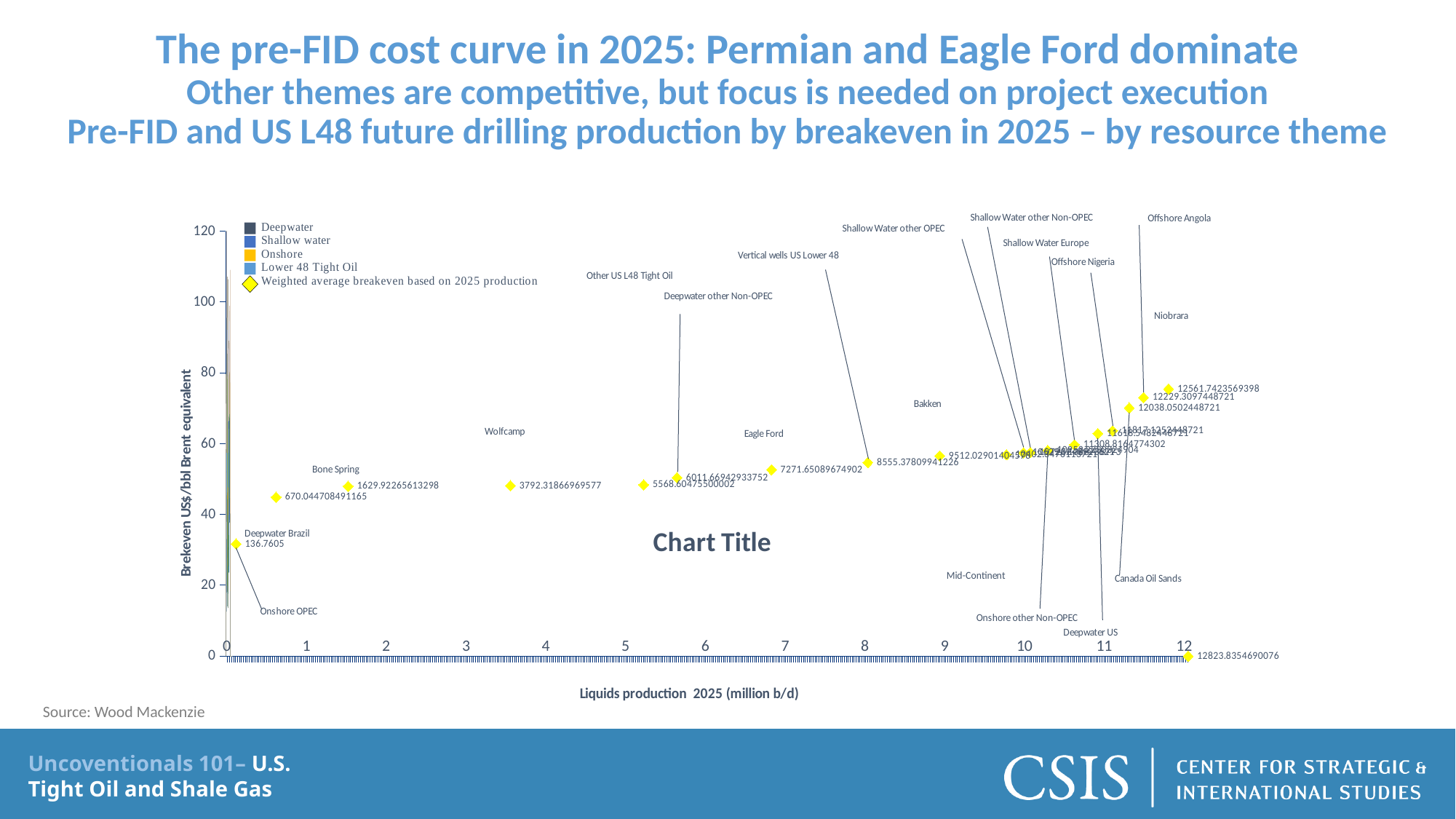
What is the label of the chart's x axis? Liquids production 2025 (million b/d) What is the label of the chart's y axis? Brekeven US$/bbl Brent equivalent Which has the higher breakeven, Eagle Ford or Deepwater Brazil? Eagle Ford What is the data label on the diamond marker for Eagle Ford? 7271.65089674902 Is the breakeven value for the point labeled 12561.7423569398 greater or less than 70? greater How many entries does the chart legend list? 5 Is the breakeven value for Deepwater Brazil greater or less than 40? greater What is the data label on the diamond marker for Deepwater Brazil? 670.044708491165 What is the data label on the diamond marker for Wolfcamp? 3792.31866969577 What is the data label on the diamond marker for Bone Spring? 1629.92265613298 Do the breakeven values of the diamond markers generally rise or fall as liquids production increases along the x axis? rise What kind of chart is shown on the slide? scatter chart